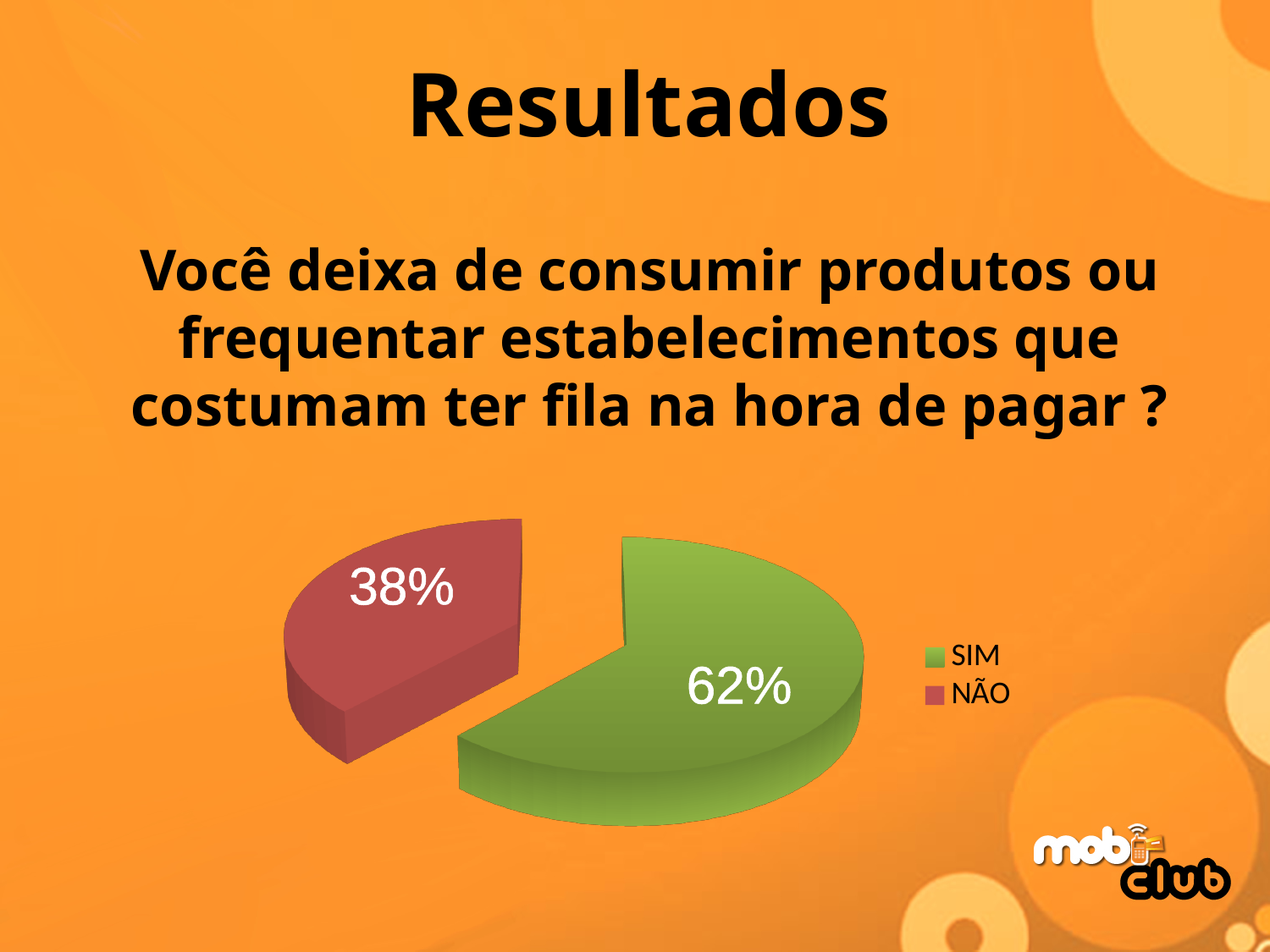
What colour is the SIM slice? green How many entries does the legend list? 2 What share of the pie does SIM represent? 62% How many slices does the pie chart have? 2 What kind of chart is shown on the slide? pie chart Which is larger, SIM or NÃO? SIM What share of the pie does NÃO represent? 38% What is the difference in percentage points between SIM and NÃO? 24 What colour is the NÃO slice? red Which slice is the largest? SIM Which slice is the smallest? NÃO